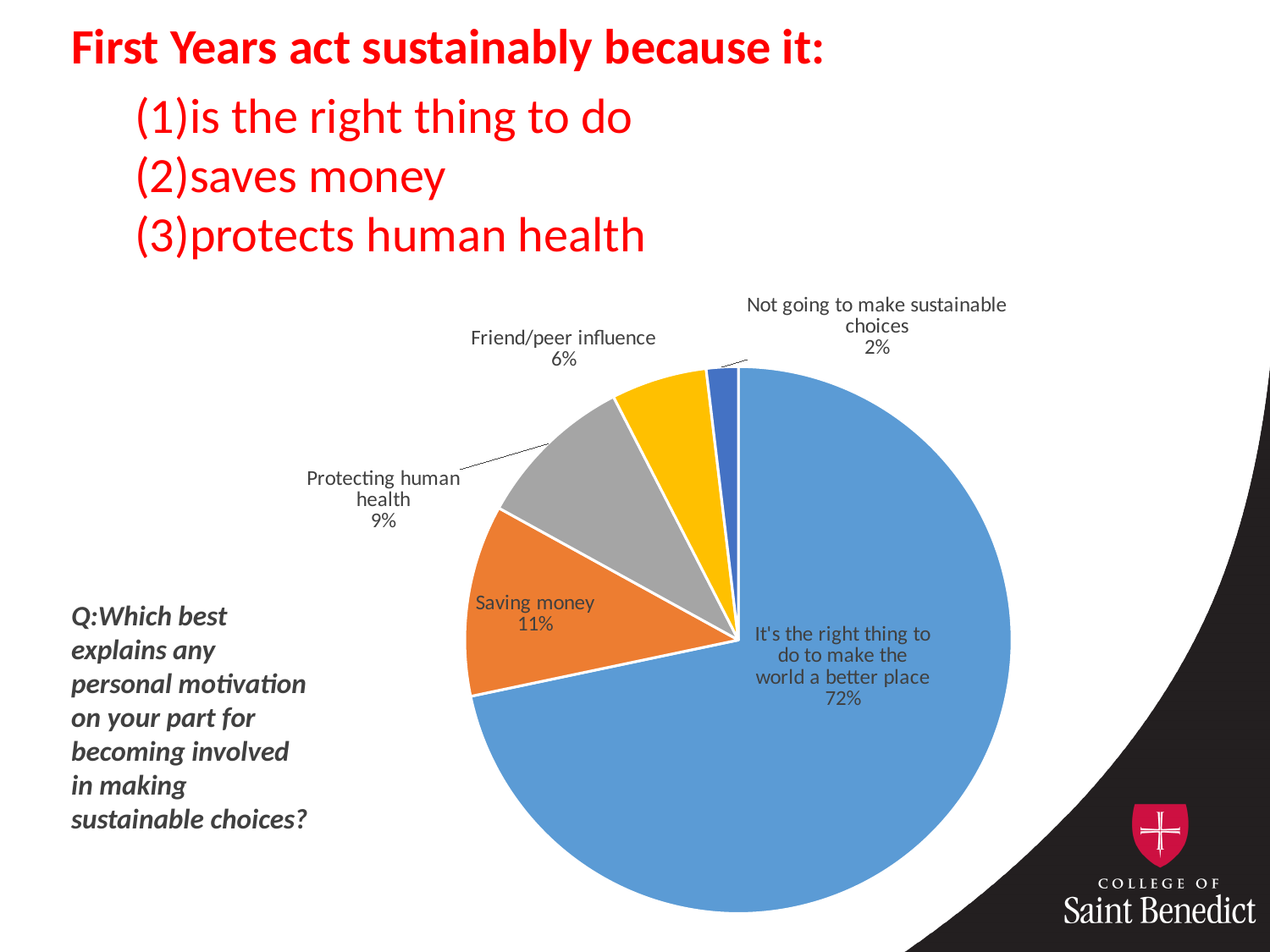
What kind of chart is shown on the slide? pie chart Which slice of the pie is the largest? It's the right thing to do to make the world a better place What share of the pie is 'Saving money'? 11% What share of the pie is 'It's the right thing to do to make the world a better place'? 72% What share of the pie is 'Friend/peer influence'? 6% What colour is the 'Saving money' slice? orange Which is larger, 'Friend/peer influence' or 'Saving money'? Saving money What is the difference in percentage points between 'Saving money' and 'Protecting human health'? 2 How many slices does the pie chart have? 5 Which slice of the pie is the smallest? Not going to make sustainable choices